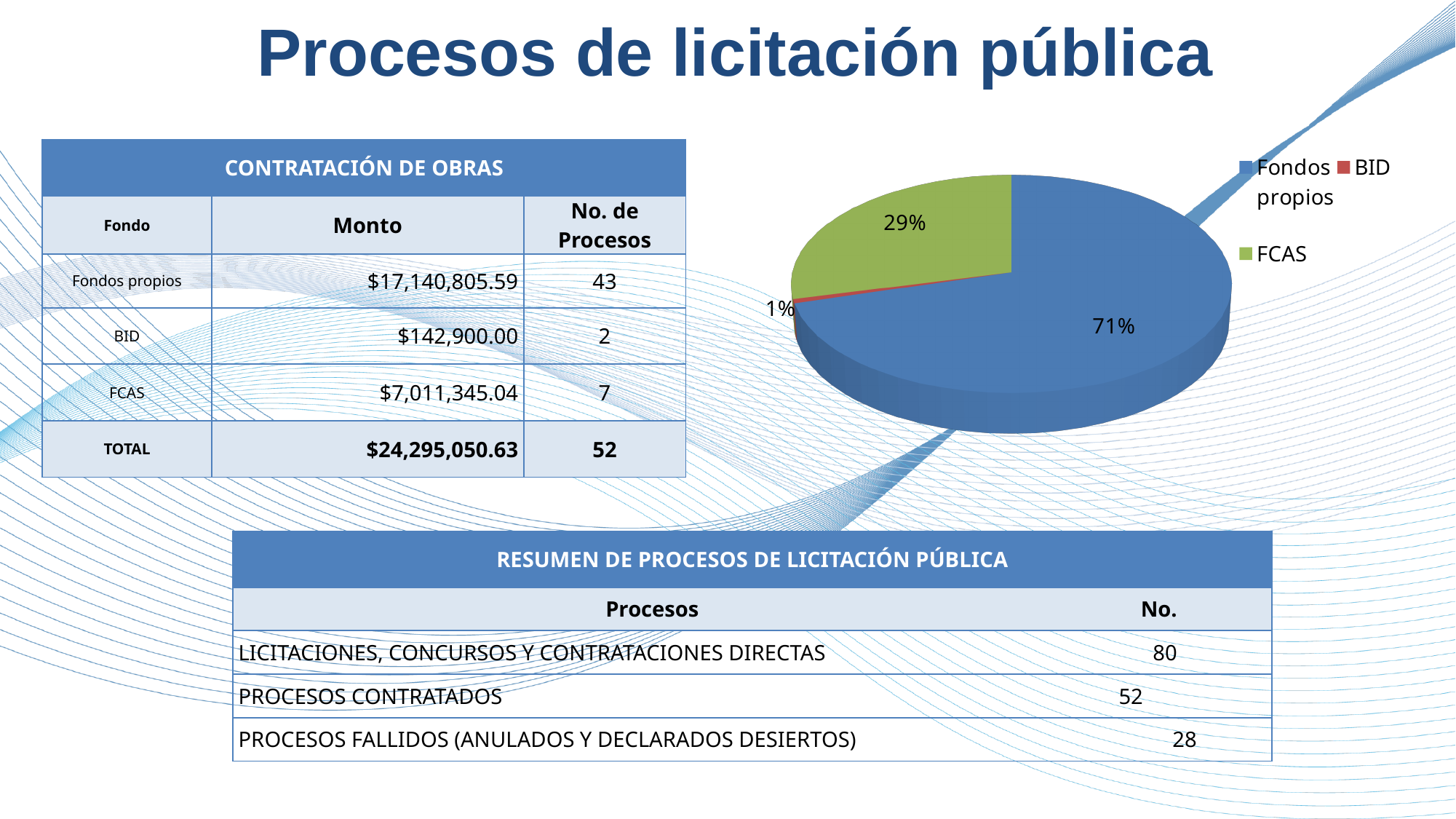
What is the difference in percentage points between the Fondos propios slice and the FCAS slice? 42 What colour is the FCAS slice in the pie chart? Green What share of the pie chart does FCAS represent? 29% What colour is the Fondos propios slice in the pie chart? Blue Which is larger in the pie chart, FCAS or BID? FCAS Which slice of the pie chart is the smallest? BID What share of the pie chart does BID represent? 1% What share of the pie chart does Fondos propios represent? 71% How many slices does the pie chart have? 3 Which slice of the pie chart is the largest? Fondos propios What kind of chart is shown on the slide? Pie chart How many entries does the pie chart legend list? 3